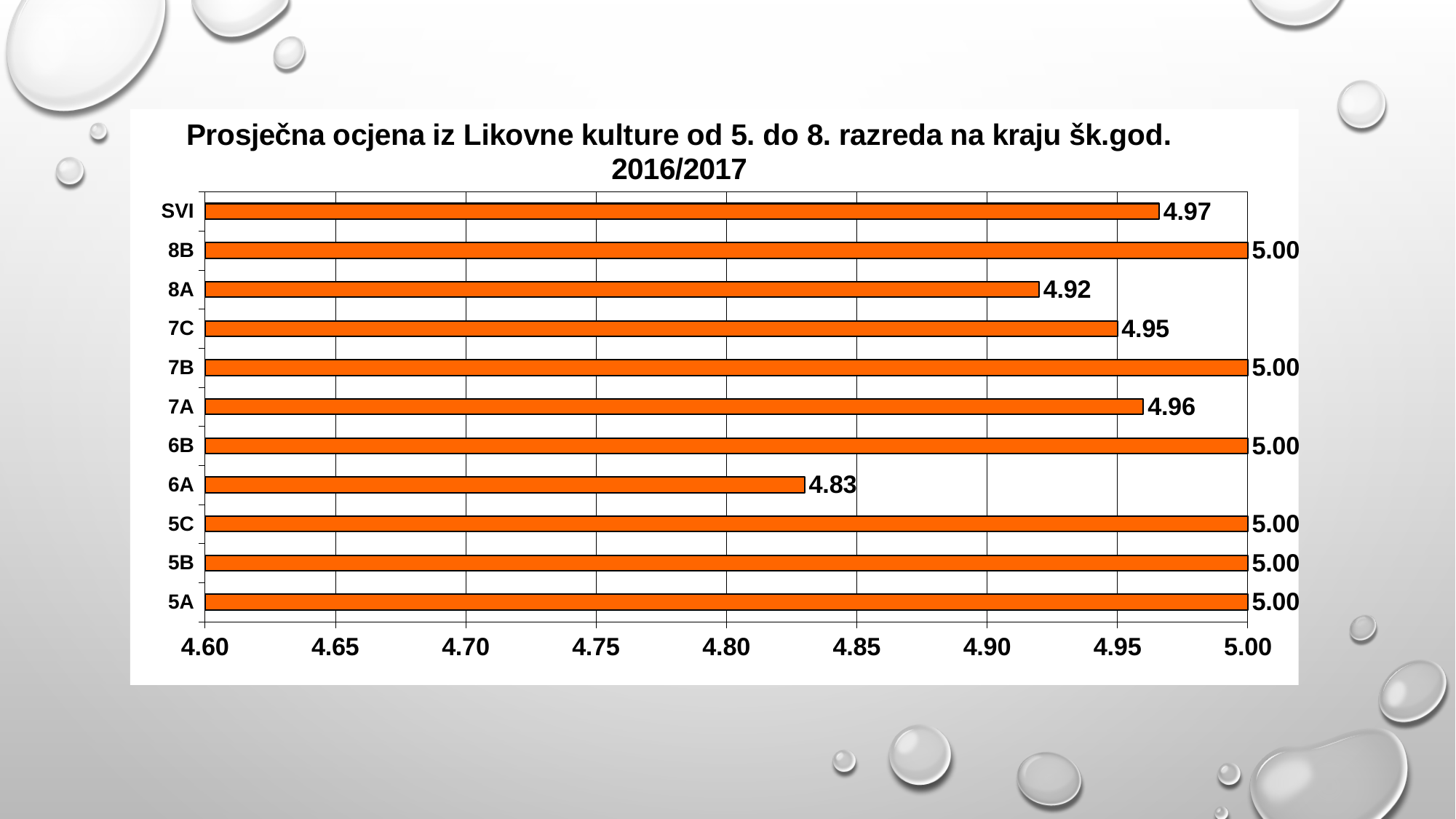
What is the value for SVI? 4.97 What kind of chart is shown on the slide? bar chart How many categories are shown on the chart? 11 What is the difference between the values for SVI and 6A? 0.14 What is the value for 7C? 4.95 Is the value for 6A greater or less than 4.85? less What is the value for 6A? 4.83 Which is larger, the value for 7A or the value for 8A? 7A How many categories have a value of 5.00? 6 What colour are the bars in the chart? orange Which category has the lowest value? 6A What is the value for 8A? 4.92